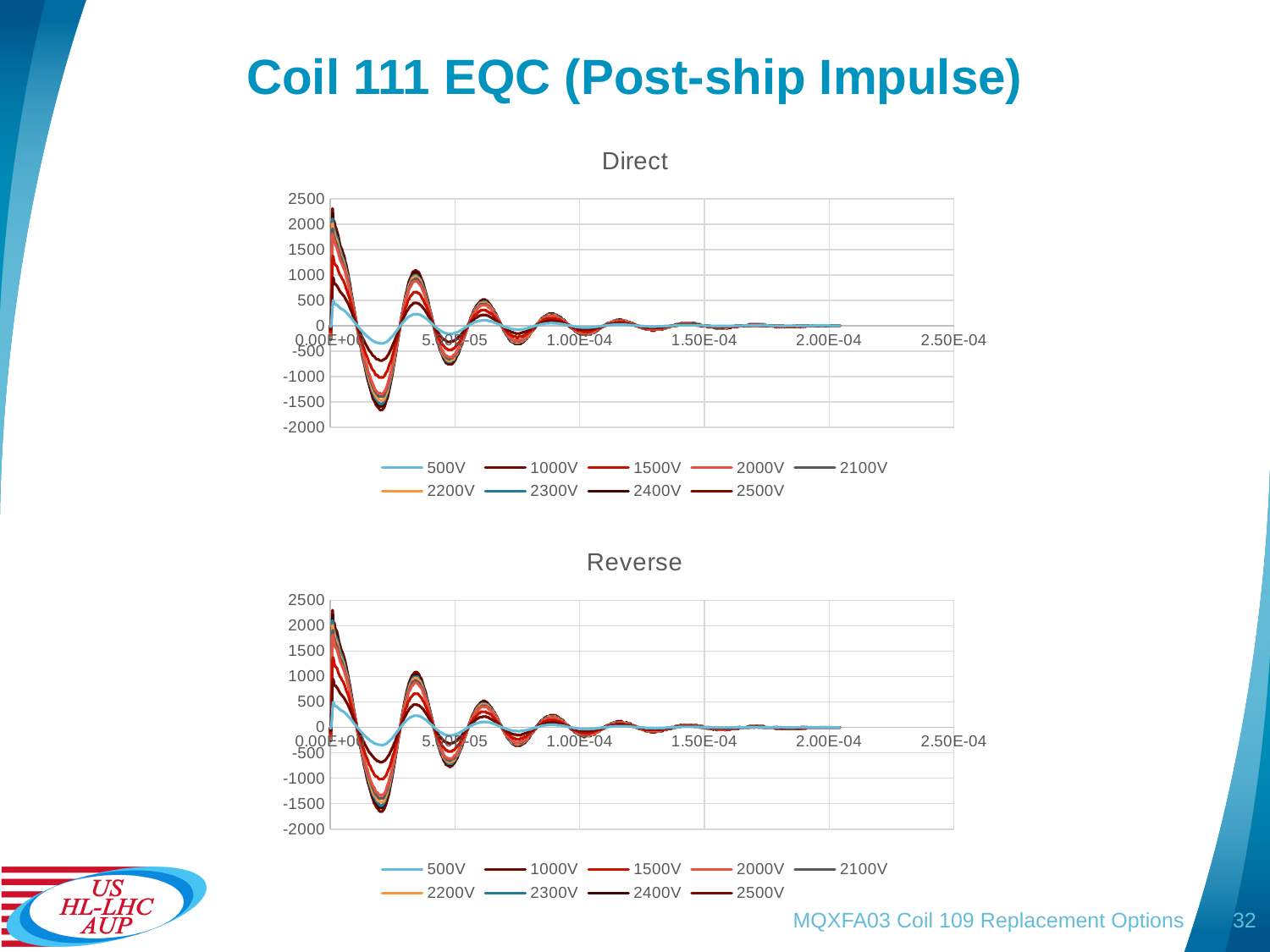
What kind of chart is the Reverse chart? line chart How many series does the legend of the Reverse chart list? 9 In the Reverse chart, is the lowest trough of the 500V series greater or less than -1000? greater In the Reverse chart, does the oscillation amplitude of the series increase or decrease along the x axis? decrease In the Direct chart, is the first peak of the 2500V series greater or less than 2000? greater How many series does the legend of the Direct chart list? 9 What is the title of the upper chart on the slide? Direct What kind of chart is the Direct chart? line chart In the Direct chart, which series has the smallest oscillation amplitude? 500V In the Direct chart, is the highest peak of the 500V series greater or less than 1000? less What is the title of the lower chart on the slide? Reverse In the Direct chart, which series has the larger first peak, 500V or 1500V? 1500V